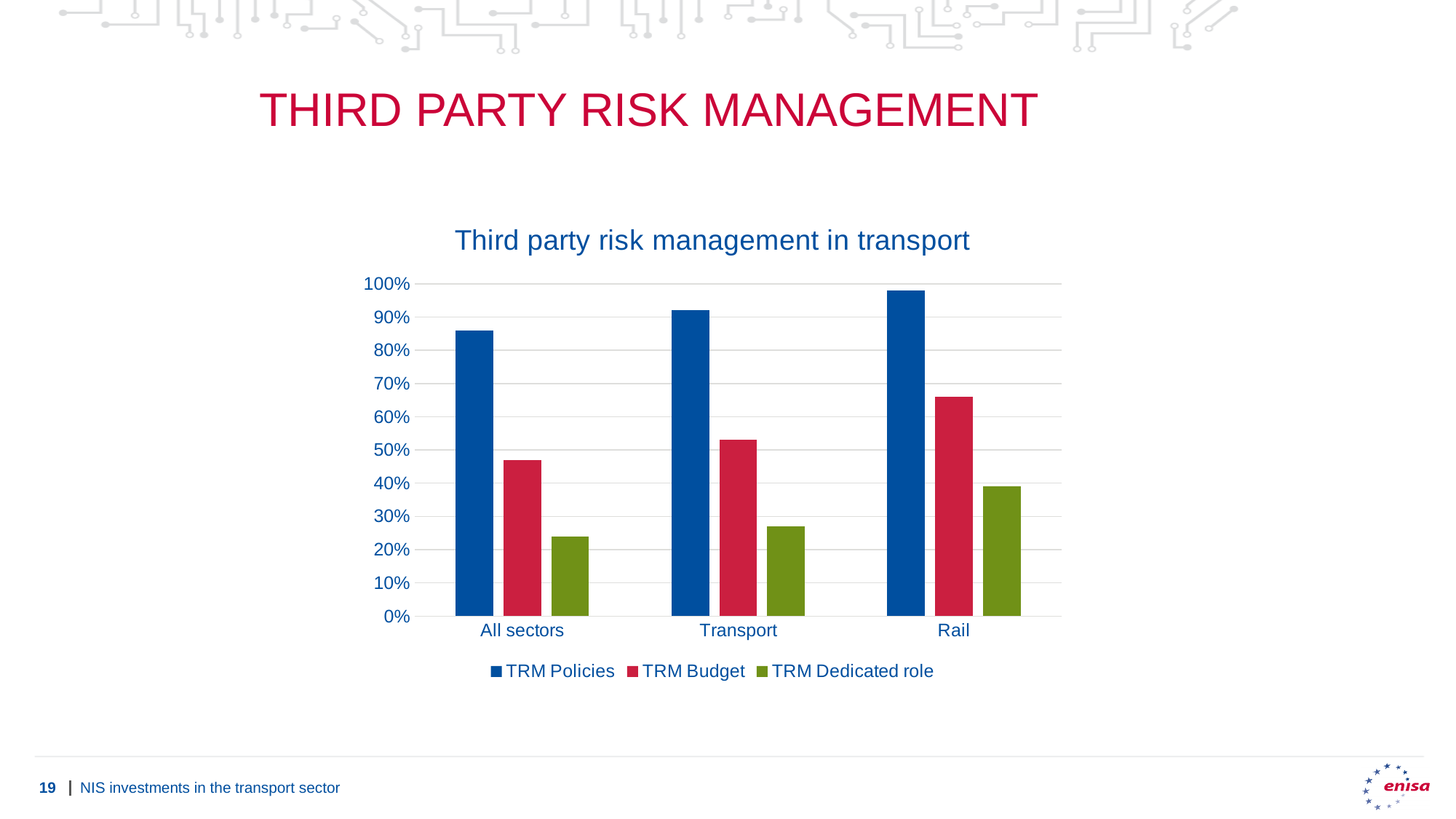
Is the TRM Dedicated role value for All sectors greater or less than 30%? less Which category has the highest value for TRM Policies? Rail Is the TRM Policies value for Rail greater or less than 90%? greater Which category has the lowest value for TRM Dedicated role? All sectors Which is larger, the TRM Budget value for Transport or for Rail? Rail Do the TRM Policies values rise or fall from All sectors to Rail? rise What is the title of the chart? Third party risk management in transport What kind of chart is shown on the slide? Bar chart How many categories are shown on the x axis? 3 How many series does the legend list? 3 Is the TRM Budget value for All sectors greater or less than 60%? less